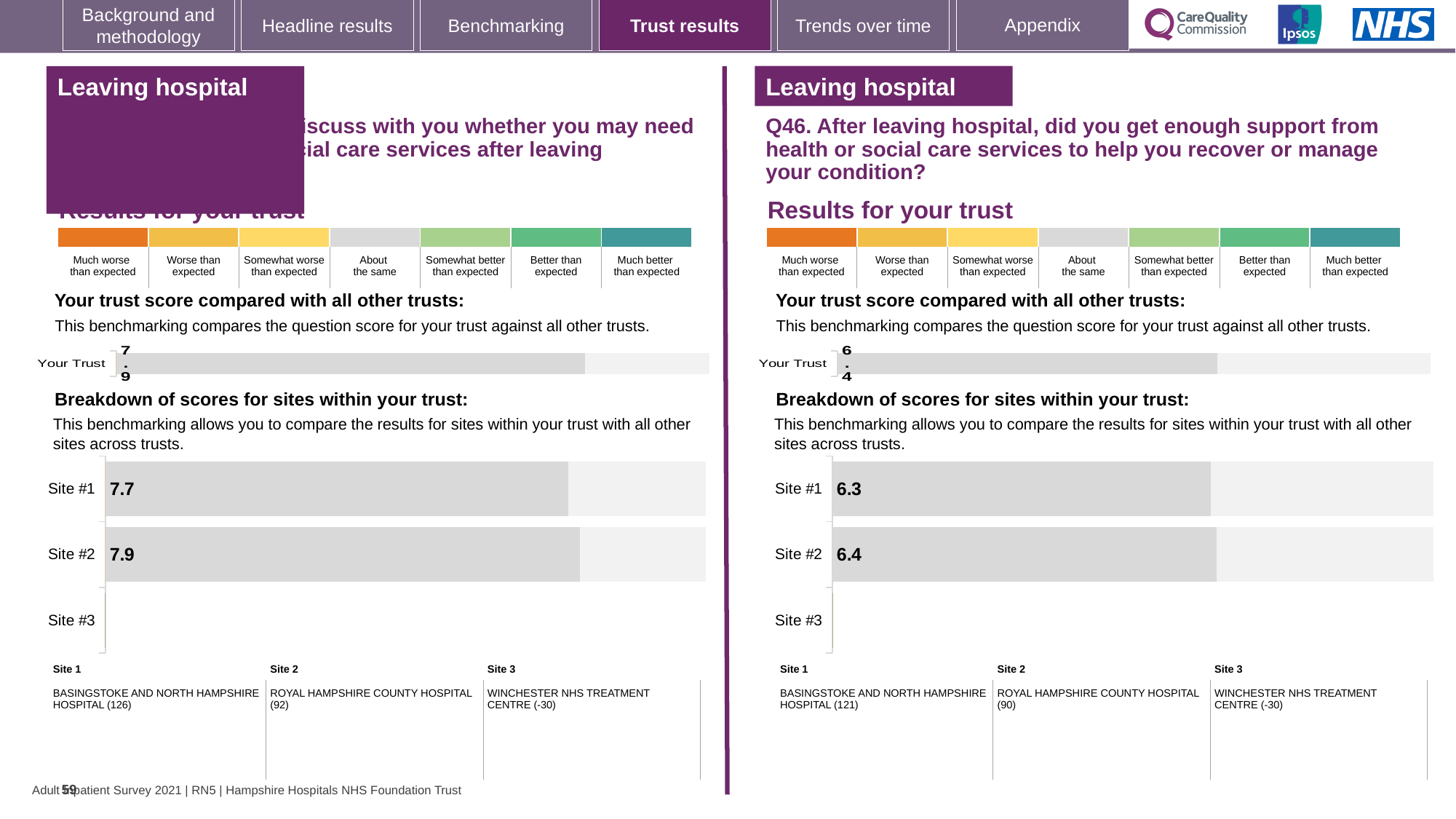
On the right-hand (Q46) site breakdown chart, which site has no bar plotted? Site #3 How many site categories are listed on the right-hand (Q46) site breakdown chart? 3 On the left-hand site breakdown chart, what is the difference between the Site #2 and Site #1 scores? 0.2 On the left-hand site breakdown chart, what is the score for Site #1? 7.7 On the left-hand site breakdown chart, what is the score for Site #2? 7.9 On the right-hand (Q46) site breakdown chart, what is the score for Site #2? 6.4 On the left-hand 'Your trust score compared with all other trusts' chart, what is the score for Your Trust? 7.9 On the right-hand (Q46) site breakdown chart, what is the difference between the Site #2 and Site #1 scores? 0.1 On the right-hand (Q46) 'Your trust score compared with all other trusts' chart, what is the score for Your Trust? 6.4 On the right-hand (Q46) site breakdown chart, what is the score for Site #1? 6.3 What type of chart is used for the site breakdown on the right-hand (Q46) side of the slide? Bar chart On the left-hand site breakdown chart, which site has the higher score, Site #1 or Site #2? Site #2